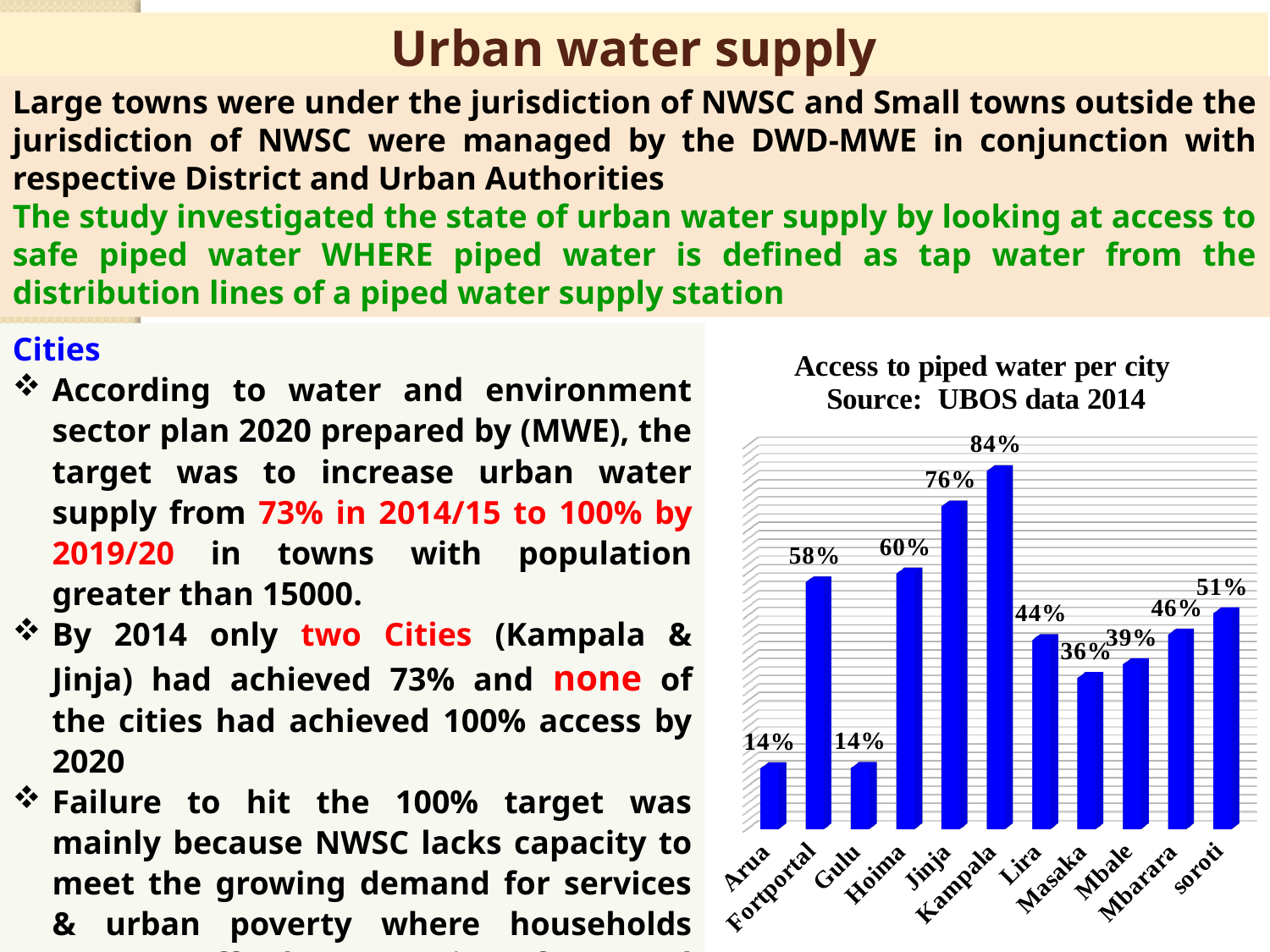
What is the access to piped water value for Kampala? 84% What type of chart is shown on the slide? Bar chart What is the access to piped water value for Hoima? 60% What is the difference between the values for Jinja and Lira? 32% What is the access to piped water value for Masaka? 36% According to the chart, what is the data source? UBOS data 2014 Which city has the highest access to piped water? Kampala How many cities are shown in the chart? 11 Which has a higher access to piped water value, Mbale or soroti? soroti What is the difference between the values for Fortportal and Mbarara? 12% What is the title of the chart? Access to piped water per city Which two cities share the lowest access to piped water value? Arua and Gulu